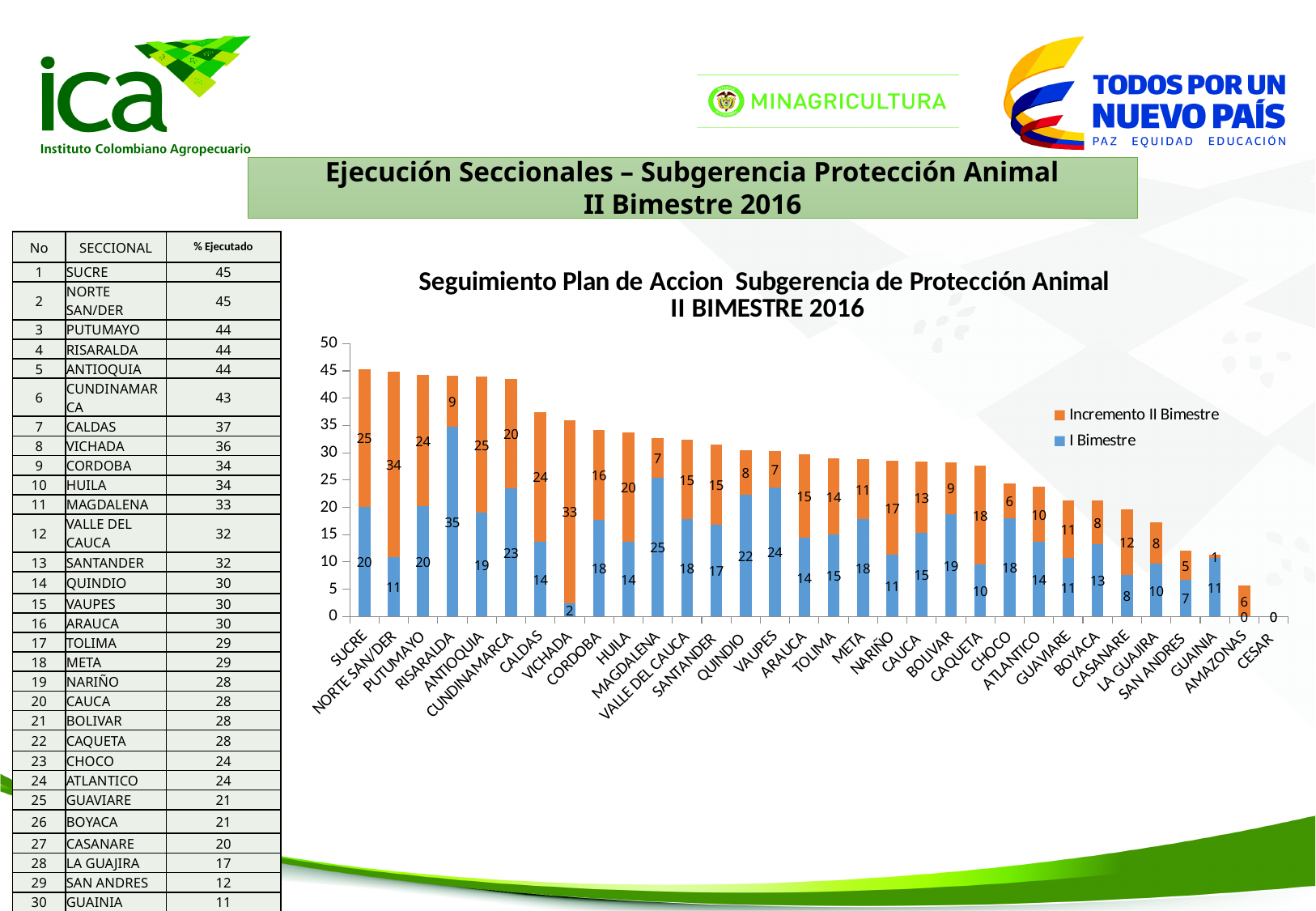
What is the I Bimestre value for RISARALDA? 35 What is the difference between the I Bimestre values of RISARALDA and VICHADA? 33 What are the two series named in the chart legend? Incremento II Bimestre and I Bimestre What is the total of the stacked bar for SUCRE? 45 What is the Incremento II Bimestre value for VICHADA? 33 How many series does the chart legend list? 2 Which has the larger I Bimestre value, QUINDIO or VAUPES? VAUPES Do the total bar heights generally rise or fall from left to right along the x axis? Fall What kind of chart is shown on the slide? Stacked bar chart Which seccional has the highest I Bimestre value? RISARALDA Which seccional has the highest Incremento II Bimestre value? NORTE SAN/DER What is the I Bimestre value for CAQUETA? 10